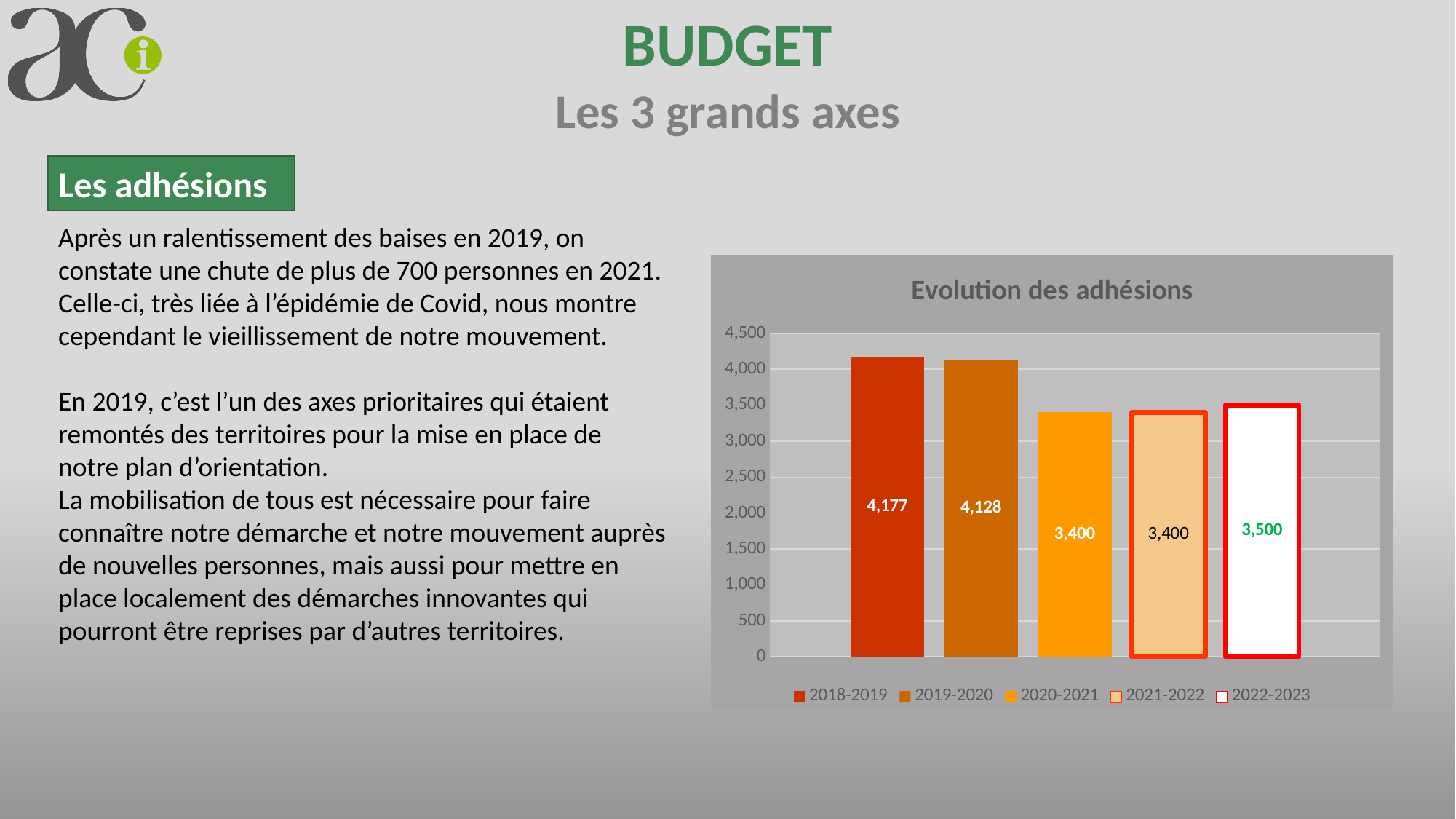
Which period has the highest value in the Evolution des adhésions chart? 2018-2019 How many entries does the legend of the Evolution des adhésions chart list? 5 Is the value for 2020-2021 greater or less than 4,000 in the Evolution des adhésions chart? less What is the title of the chart on the slide? Evolution des adhésions How many bars are plotted in the Evolution des adhésions chart? 5 What kind of chart is the Evolution des adhésions chart? Bar chart Which is larger in the Evolution des adhésions chart, the value for 2021-2022 or the value for 2022-2023? 2022-2023 What is the value for 2022-2023 in the Evolution des adhésions chart? 3,500 What is the difference between the 2019-2020 and 2020-2021 values in the Evolution des adhésions chart? 728 What is the value for 2019-2020 in the Evolution des adhésions chart? 4,128 What is the difference between the 2018-2019 and 2019-2020 values in the Evolution des adhésions chart? 49 What is the value for 2018-2019 in the Evolution des adhésions chart? 4,177